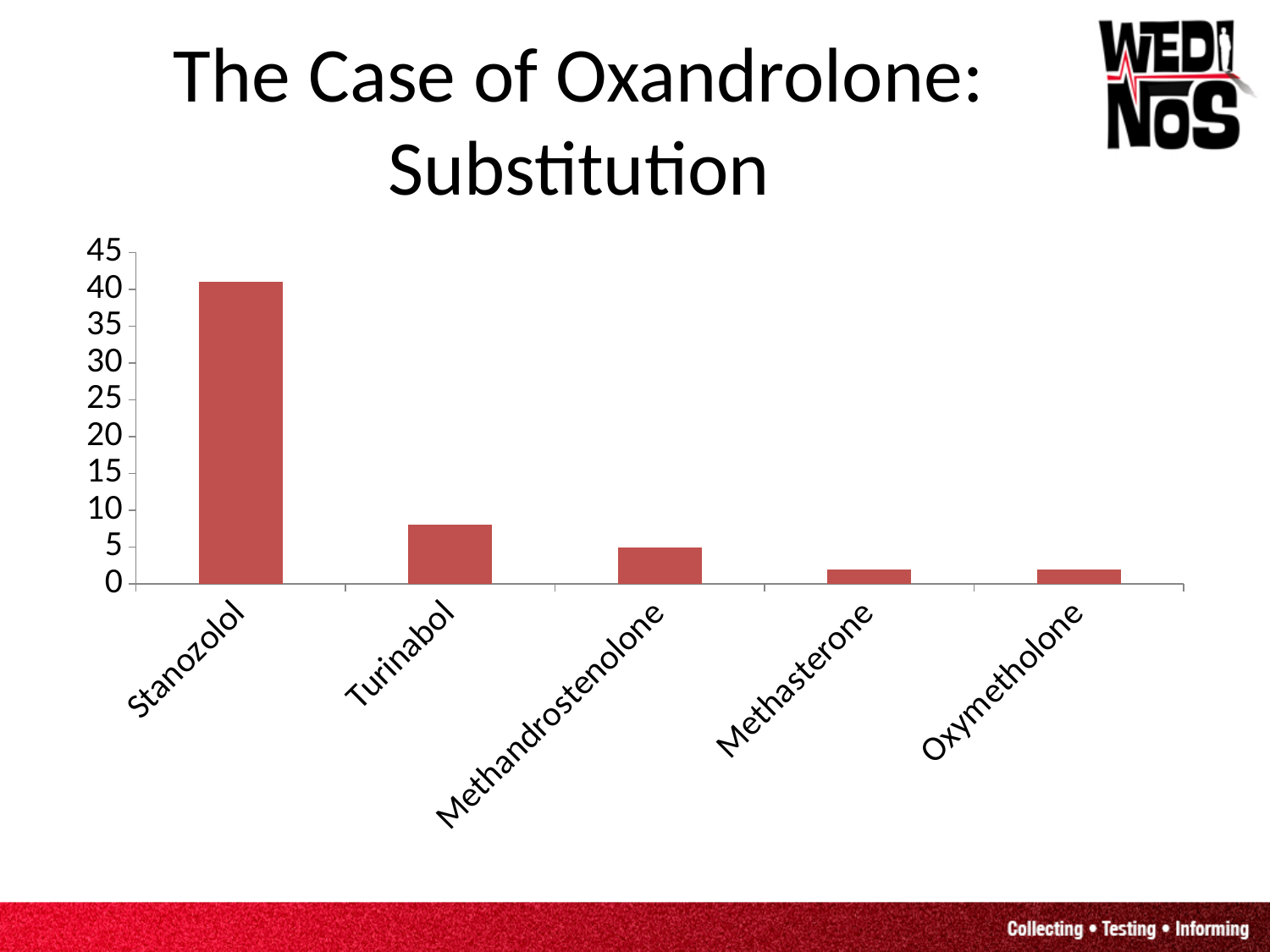
Which is larger, the value for Stanozolol or the value for Turinabol? Stanozolol Is the value for Stanozolol greater or less than 45? less Is the value for Turinabol greater or less than 10? less Is the value for Methasterone greater or less than 5? less Which category has the highest value in the chart? Stanozolol What kind of chart is shown on the slide? bar chart What is the title of the slide containing the chart? The Case of Oxandrolone: Substitution How many categories are shown on the x axis of the chart? 5 Which is larger, the value for Turinabol or the value for Methandrostenolone? Turinabol